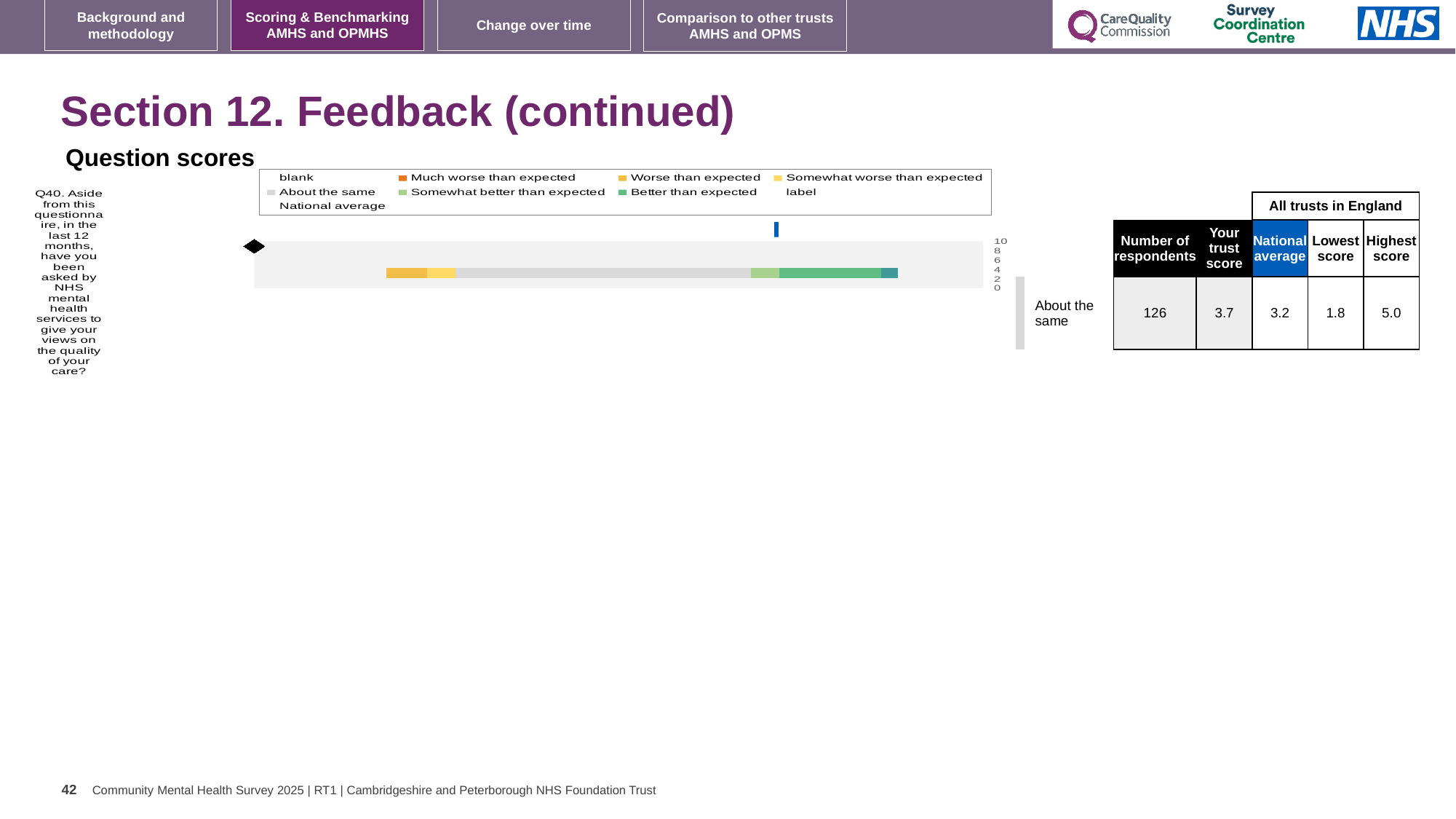
Which legend entry is shown in orange? Much worse than expected Which question number is plotted in the chart? Q40 In the table beside the chart, what is the lowest score among all trusts in England for Q40? 1.8 In the table beside the chart, what is the difference between the highest score and the lowest score for Q40? 3.2 In the table beside the chart, what is the national average for Q40? 3.2 How many question categories are plotted in the chart? 1 In the table beside the chart, what is 'Your trust score' for Q40? 3.7 What kind of chart is shown under 'Question scores'? bar chart In the table beside the chart, what is the highest score among all trusts in England for Q40? 5.0 In the table beside the chart, what is the number of respondents for Q40? 126 How many entries does the chart legend list? 9 In the table beside the chart, which is larger for Q40: your trust score or the national average? Your trust score